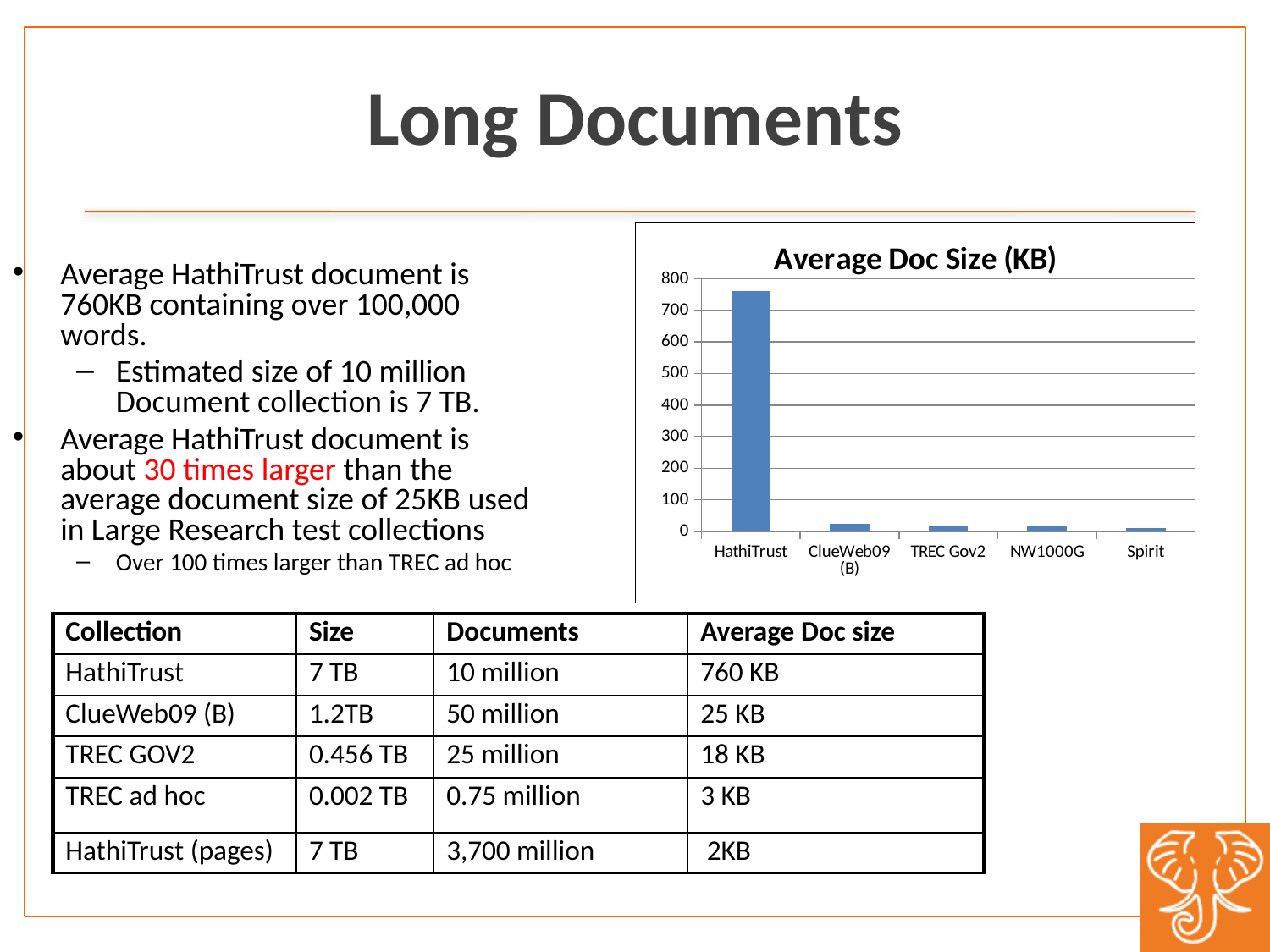
Is the value for Spirit in the chart greater or less than 100? less Which has a larger average document size in the chart, HathiTrust or ClueWeb09 (B)? HathiTrust Is the value for ClueWeb09 (B) in the chart greater or less than 100? less How many collections are plotted in the chart? 5 Which collection has the highest average document size in the chart? HathiTrust What colour are the bars in the chart? blue Do the bar values generally rise or fall from left to right across the chart? fall Which has a larger average document size in the chart, ClueWeb09 (B) or Spirit? ClueWeb09 (B) What kind of chart is shown on the slide? bar chart What is the title of the chart? Average Doc Size (KB) Is the value for HathiTrust in the chart greater or less than 700? greater